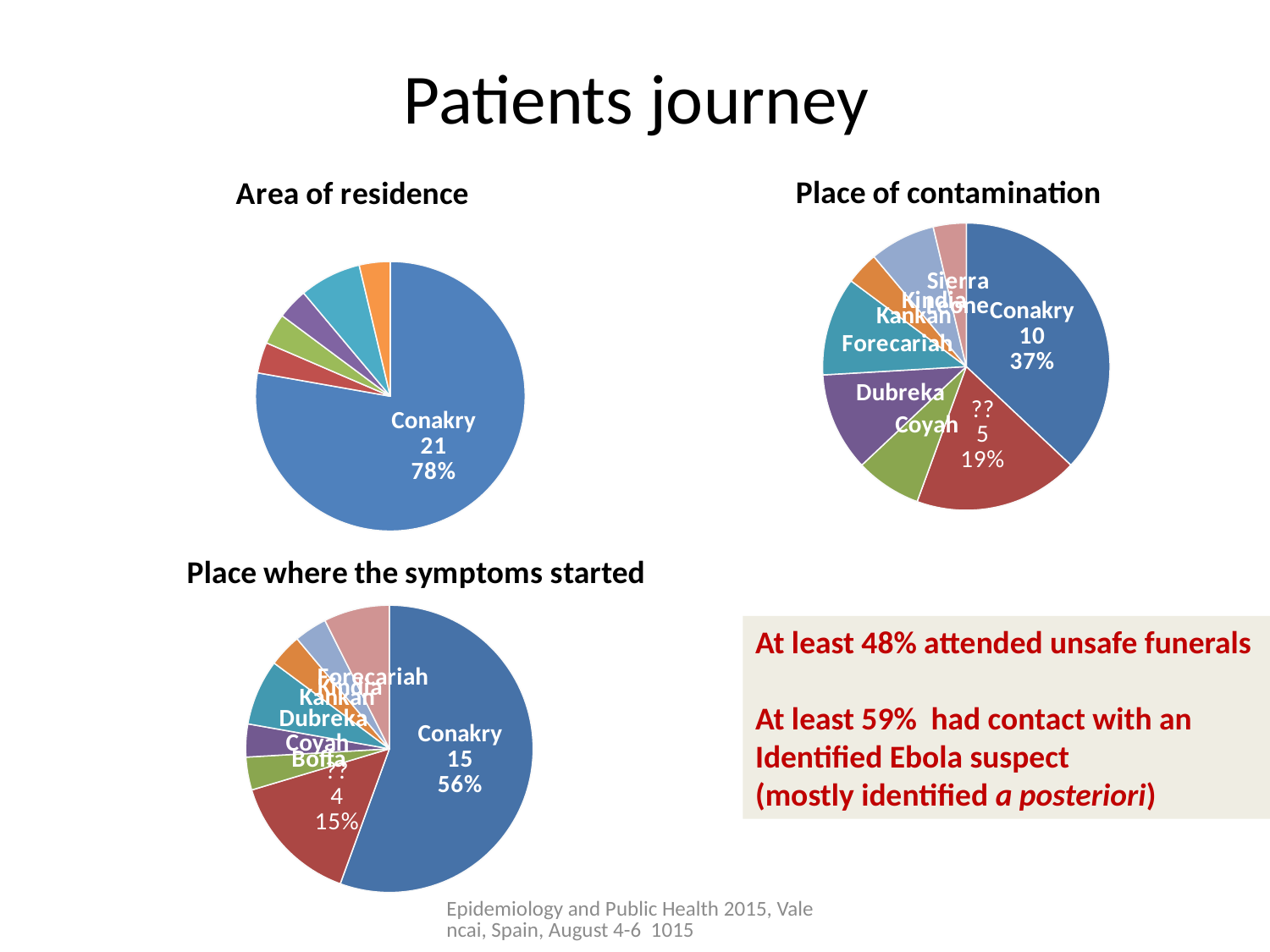
What type of chart is used for 'Place of contamination'? Pie chart How many slices does the 'Area of residence' pie chart have? 6 In the 'Place of contamination' pie chart, which is larger, the Conakry slice or the '??' slice? Conakry In the 'Area of residence' pie chart, what share of the pie does Conakry represent? 78% In the 'Place where the symptoms started' pie chart, what is the difference between the Conakry value and the '??' value? 11 In the 'Place of contamination' pie chart, what is the value of the slice labelled '??'? 5 In the 'Area of residence' chart, which category has the largest slice? Conakry In the 'Area of residence' pie chart, how many patients are from Conakry? 21 In the 'Place of contamination' pie chart, what is the value for Conakry? 10 In the 'Place where the symptoms started' pie chart, what is the value for Conakry? 15 In the 'Place of contamination' pie chart, what percentage share does Conakry have? 37% In the 'Place where the symptoms started' pie chart, what share of the pie does the '??' slice represent? 15%